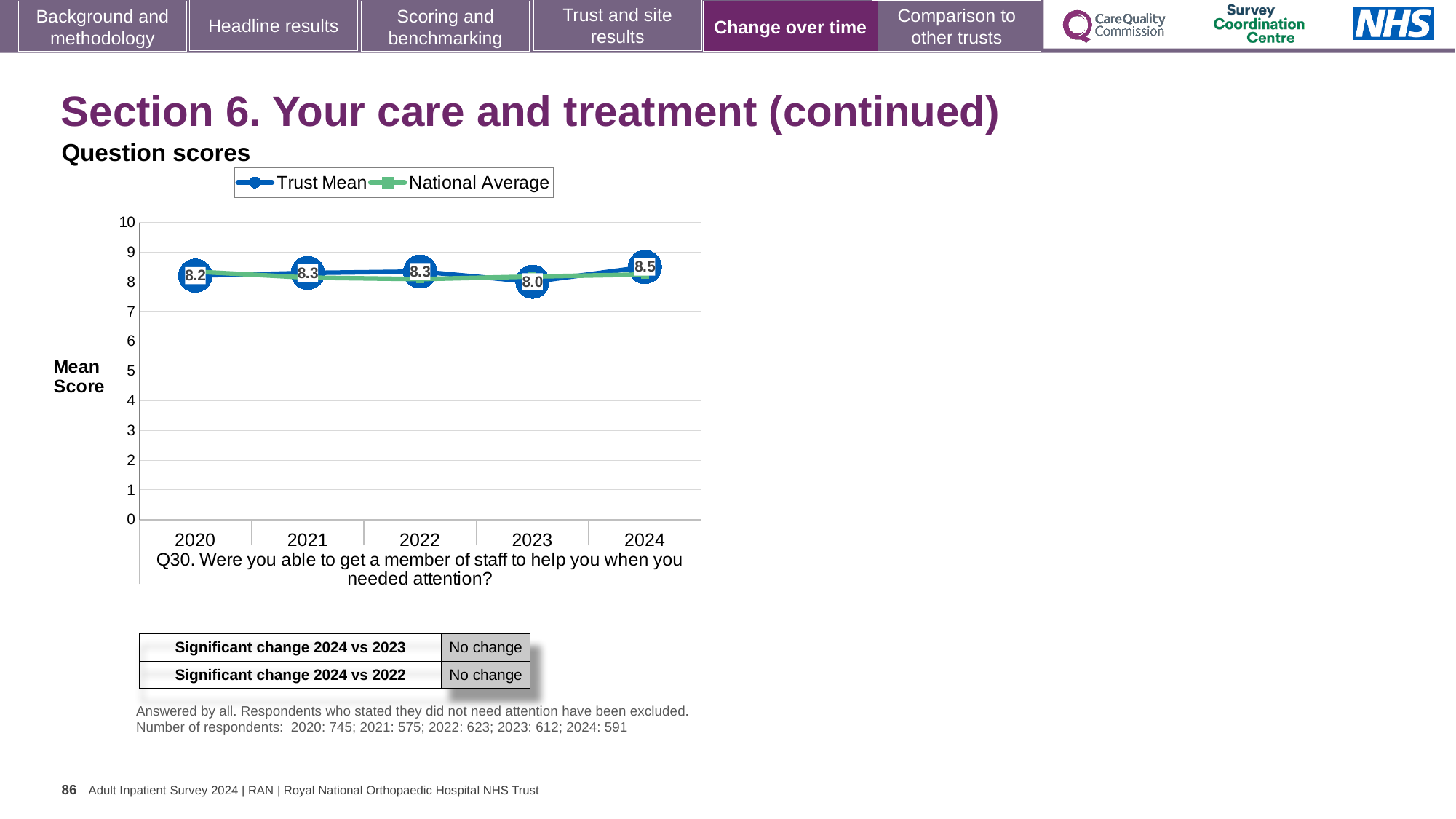
In which year is the Trust Mean highest? 2024 What is the Trust Mean value for 2020? 8.2 What kind of chart is shown on the slide? Line chart How many years are plotted on the x axis? 5 Which year has the larger Trust Mean, 2023 or 2024? 2024 Is the National Average value for 2022 greater or less than 5? greater How many series does the legend list? 2 What is the Trust Mean value for 2023? 8.0 What is the Trust Mean value for 2024? 8.5 In which year is the Trust Mean lowest? 2023 What is the difference between the Trust Mean in 2024 and in 2023? 0.5 Does the Trust Mean rise or fall from 2023 to 2024? Rise